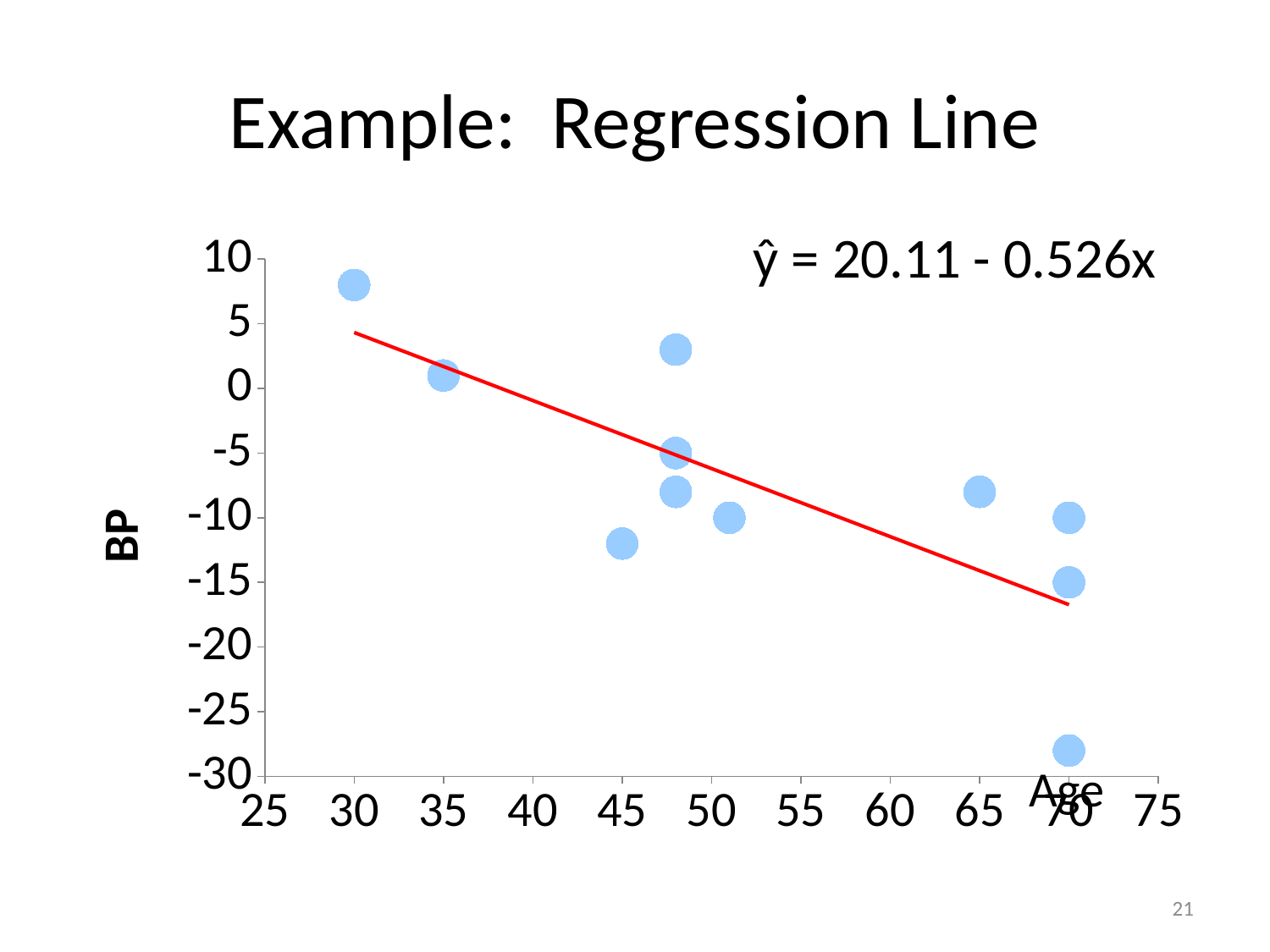
Do the BP values generally rise or fall as Age increases along the x axis? fall At which Age is the point with the lowest BP value located? 70 Is the BP value for the point at Age 45 greater or less than -10? less Which has the higher BP value: the point at Age 30 or the point at Age 65? Age 30 What is the label of the vertical axis? BP What is the regression equation printed on the chart? ŷ = 20.11 - 0.526x Is the BP value for the lowest point at Age 70 greater or less than -25? less What kind of chart is shown on the slide? scatter plot Is the BP value for the point at Age 30 greater or less than 5? greater At which Age is the point with the highest BP value located? 30 How many data points are plotted on the chart? 11